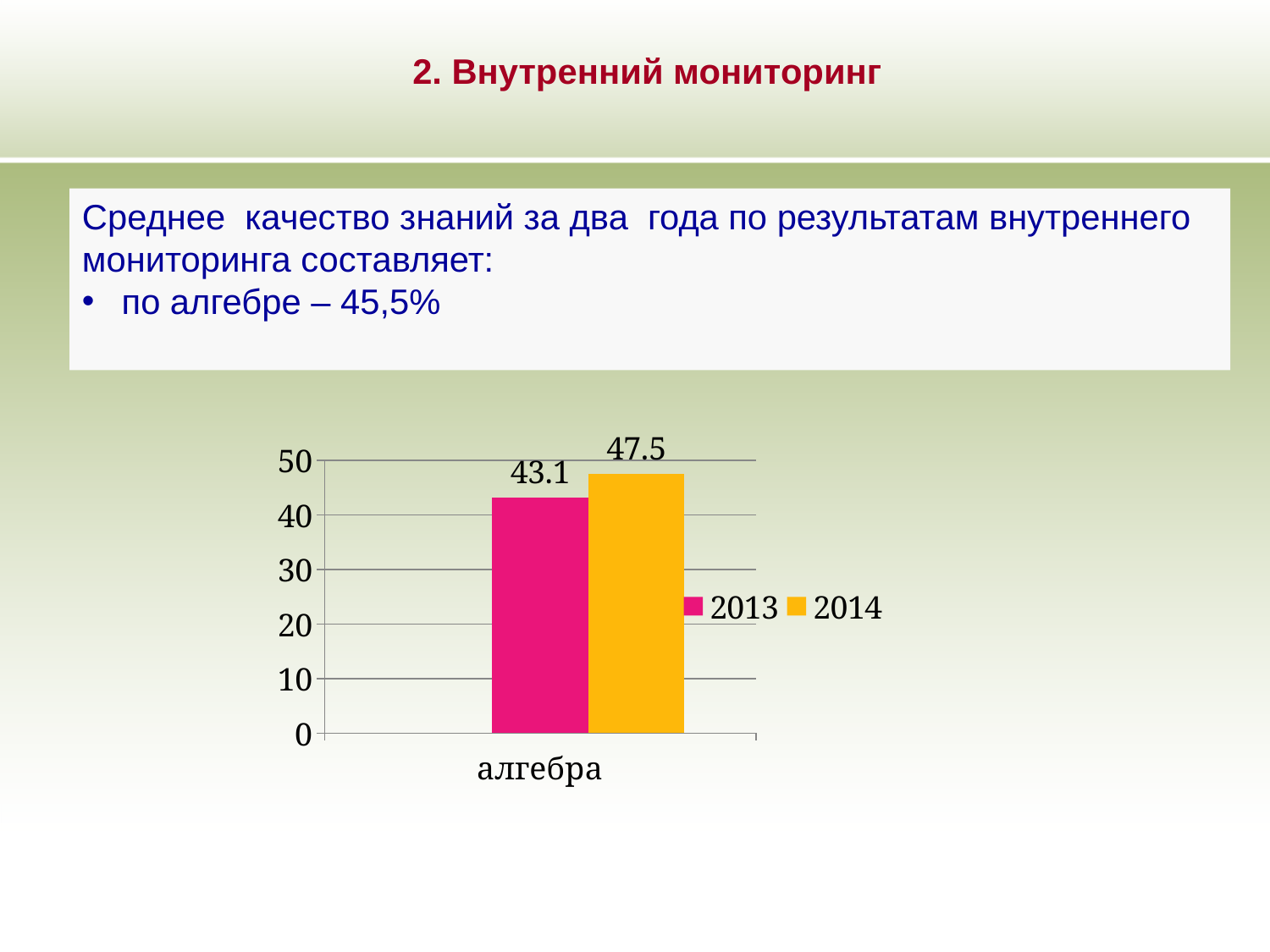
What is the difference between the 2014 and 2013 values for алгебра? 4.4 How many categories are shown on the x axis of the chart? 1 Is the value for 2013 for алгебра greater or less than 40? greater What is the value for 2014 for алгебра? 47.5 What is the value for 2013 for алгебра? 43.1 What is the category label on the x axis of the chart? алгебра Is the value for 2014 for алгебра greater or less than 50? less Which series has the higher value for алгебра, 2013 or 2014? 2014 What kind of chart is shown on the slide? bar chart Which series is shown in yellow in the chart? 2014 What is the highest value shown on the y axis of the chart? 50 How many series does the legend list? 2